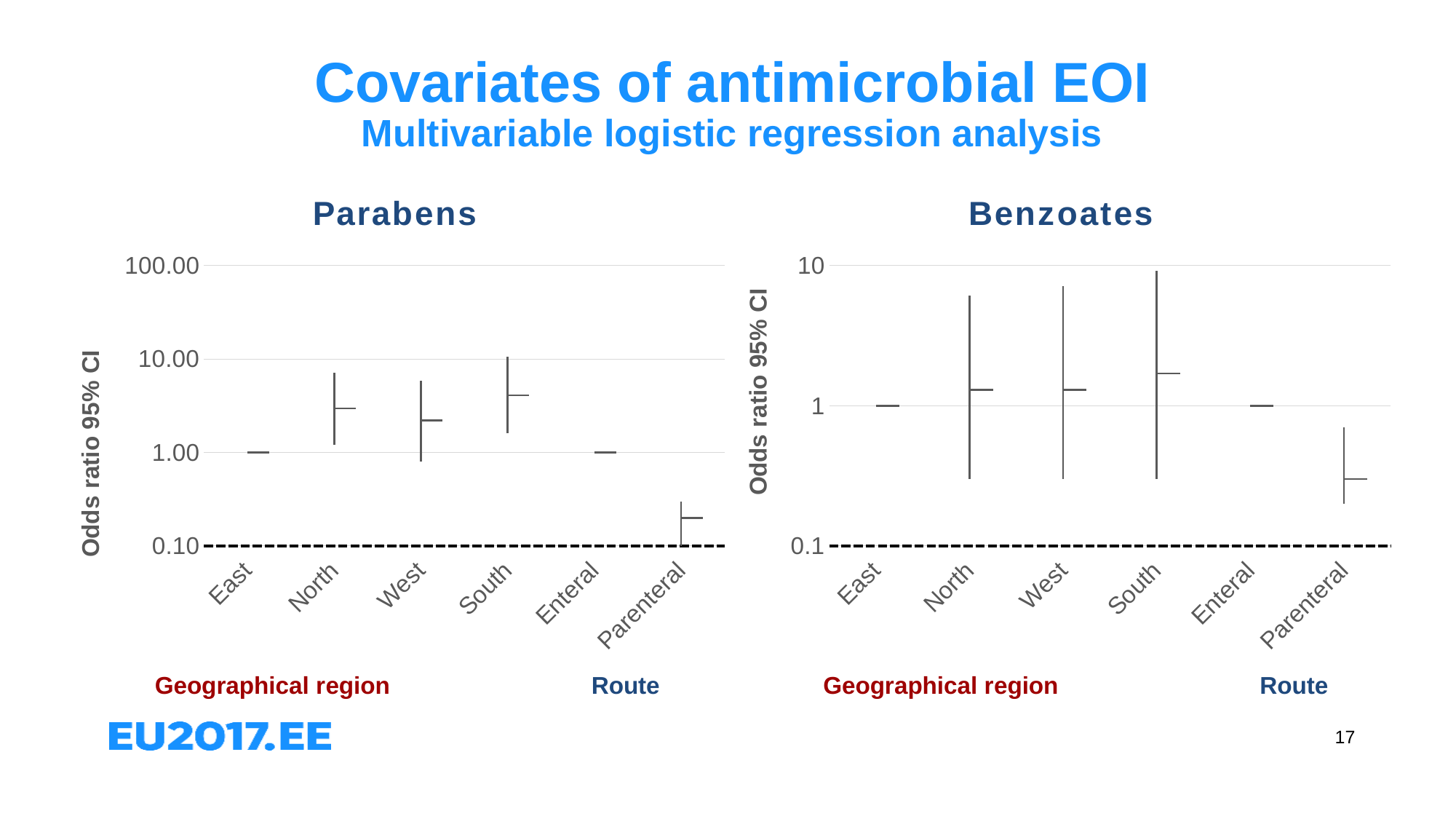
In the Parabens chart, what is the odds ratio for East? 1.00 In the Parabens chart, is the odds ratio for Parenteral greater or less than 1.00? less In the Parabens chart, which category has the highest odds ratio point estimate? South What is the highest value shown on the y axis of the Parabens chart? 100.00 In the Parabens chart, which has the larger odds ratio point estimate, North or West? North In the Benzoates chart, is the odds ratio for Parenteral greater or less than 1? less In the Parabens chart, how many categories are shown on the x axis? 6 What is the y-axis label of the Benzoates chart? Odds ratio 95% CI In the Benzoates chart, what is the odds ratio for Enteral? 1 In the Benzoates chart, which category has the lowest odds ratio point estimate? Parenteral In the Benzoates chart, is the odds ratio for South greater or less than 1? greater